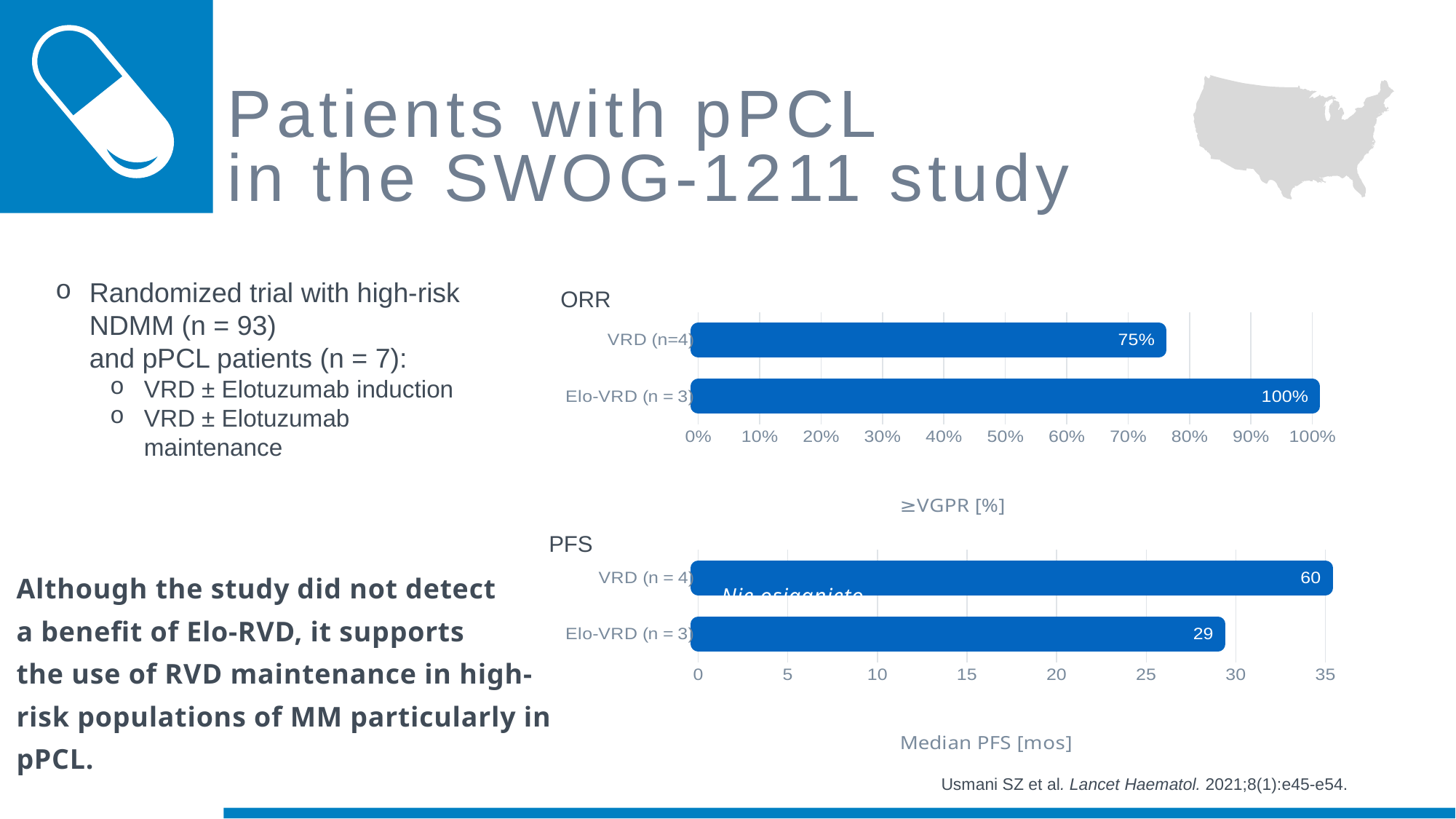
In the ORR chart, what is the value for Elo-VRD (n = 3)? 100% In the PFS chart, what is the value for VRD (n = 4)? 60 What kind of chart is the PFS chart? Bar chart In the ORR chart, what is the value for VRD (n=4)? 75% In the PFS chart, what is the difference between the VRD (n = 4) and Elo-VRD (n = 3) values? 31 In the ORR chart, what is the difference between the Elo-VRD (n = 3) and VRD (n=4) values? 25% How many categories are shown in the ORR chart? 2 In the PFS chart, is the value for Elo-VRD (n = 3) greater or less than 25? greater In the ORR chart, which category has the higher value? Elo-VRD (n = 3) What is the axis label shown below the PFS chart? Median PFS [mos] In the PFS chart, which category has the lower value? Elo-VRD (n = 3) In the PFS chart, what is the value for Elo-VRD (n = 3)? 29